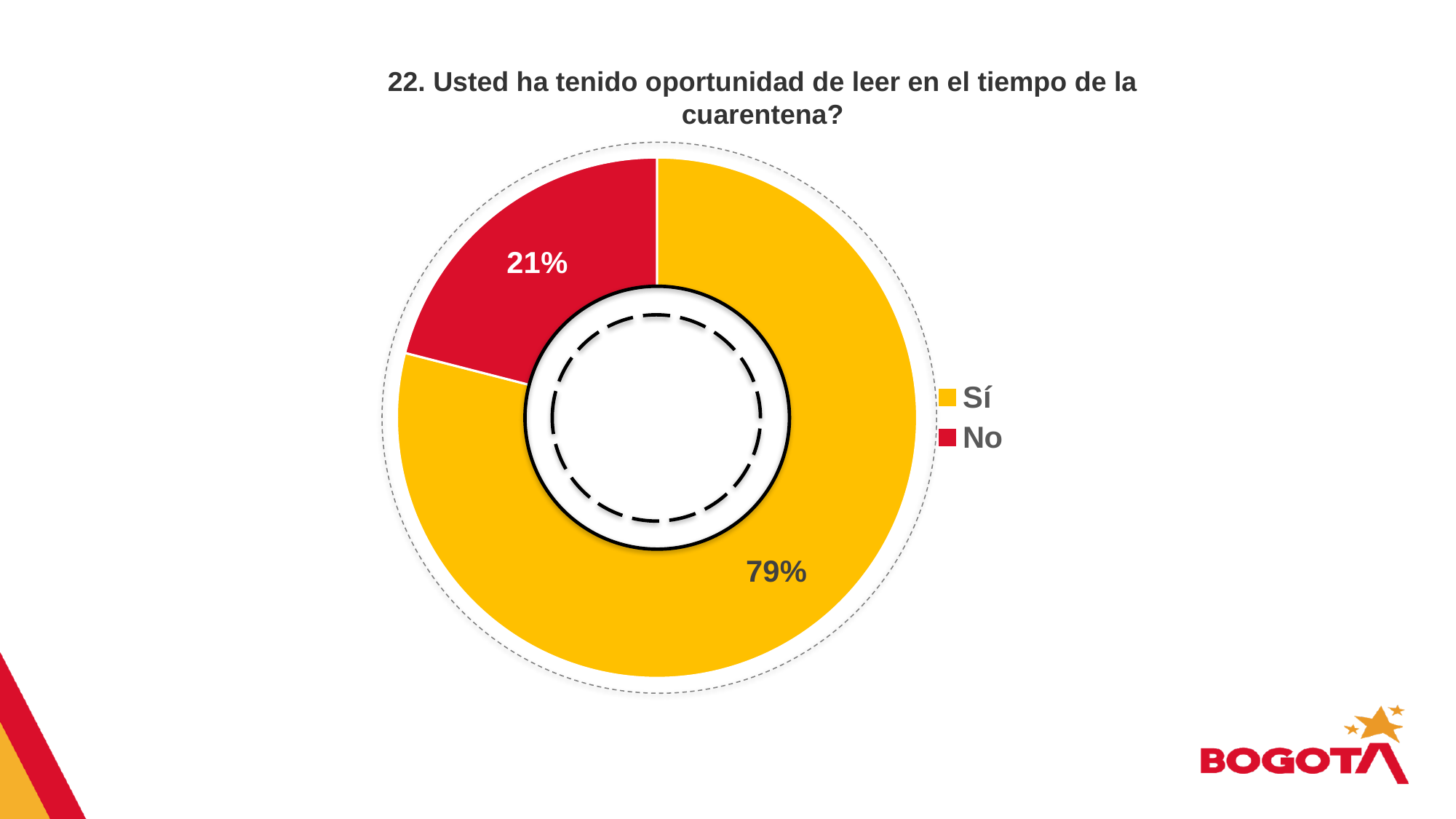
What is the difference in percentage points between the "Sí" and "No" shares? 58 Which is larger, the share for "Sí" or the share for "No"? Sí What kind of chart is shown on the slide? Pie chart (doughnut) How many categories does the chart show? 2 What is the title of the chart? 22. Usted ha tenido oportunidad de leer en el tiempo de la cuarentena? Which response has the largest share of the chart? Sí What share of the pie does the "No" slice represent? 21% What percentage of respondents answered "Sí"? 79% Which response has the smallest share of the chart? No What percentage of respondents answered "No"? 21% What colour represents the "No" category in the legend? Red